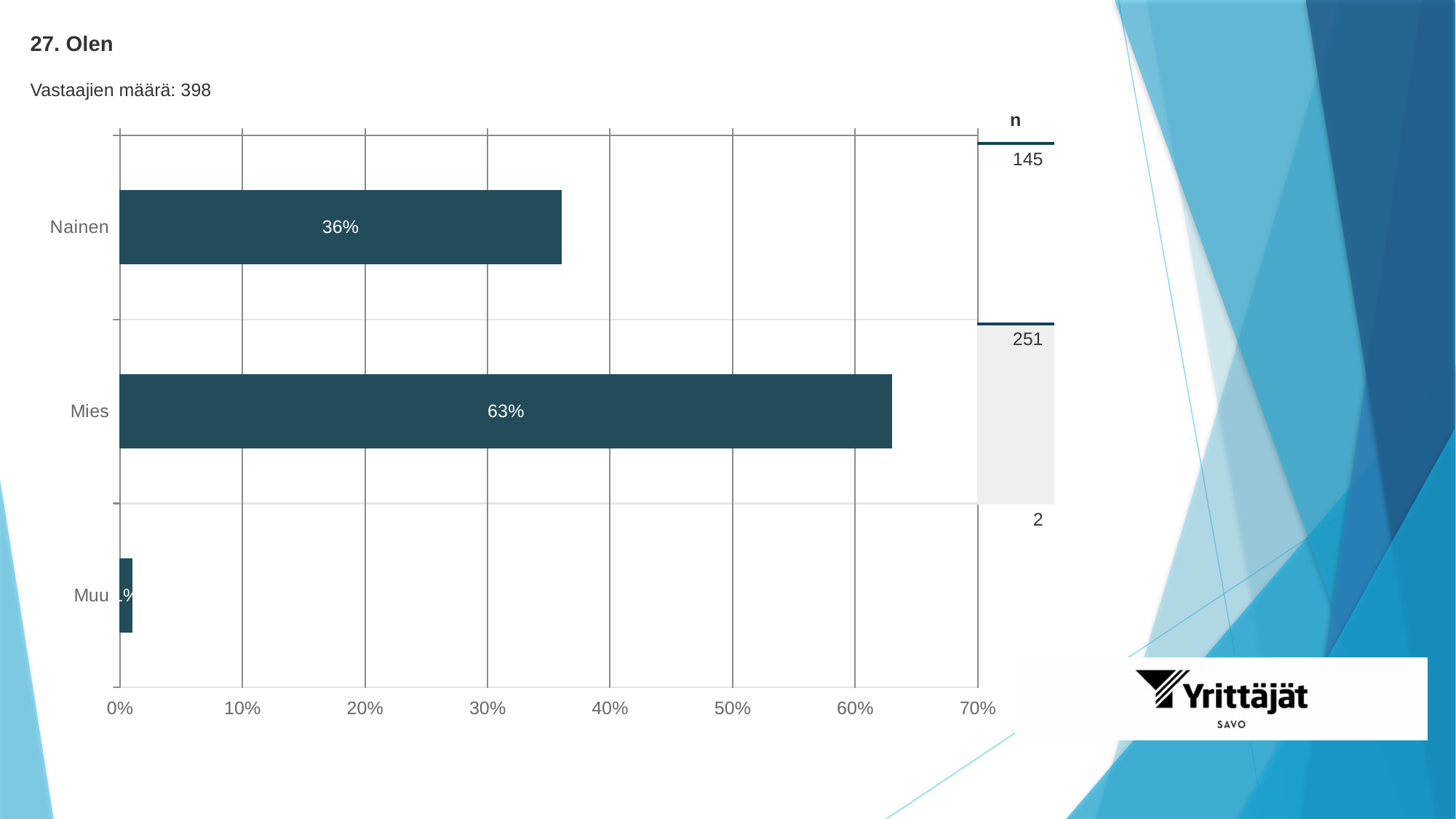
What is the n value shown for Muu? 2 How many categories are shown in the chart? 3 Which category has the lowest percentage? Muu What percentage is shown for Mies? 63% What percentage is shown for Nainen? 36% Which is larger, the percentage for Nainen or for Mies? Mies What kind of chart is shown on the slide? bar chart Which category has the highest percentage? Mies What is the difference in percentage points between Mies and Nainen? 27 What is the n value shown for Mies? 251 What is the n value shown for Nainen? 145 Is the value for Muu greater or less than 10%? less